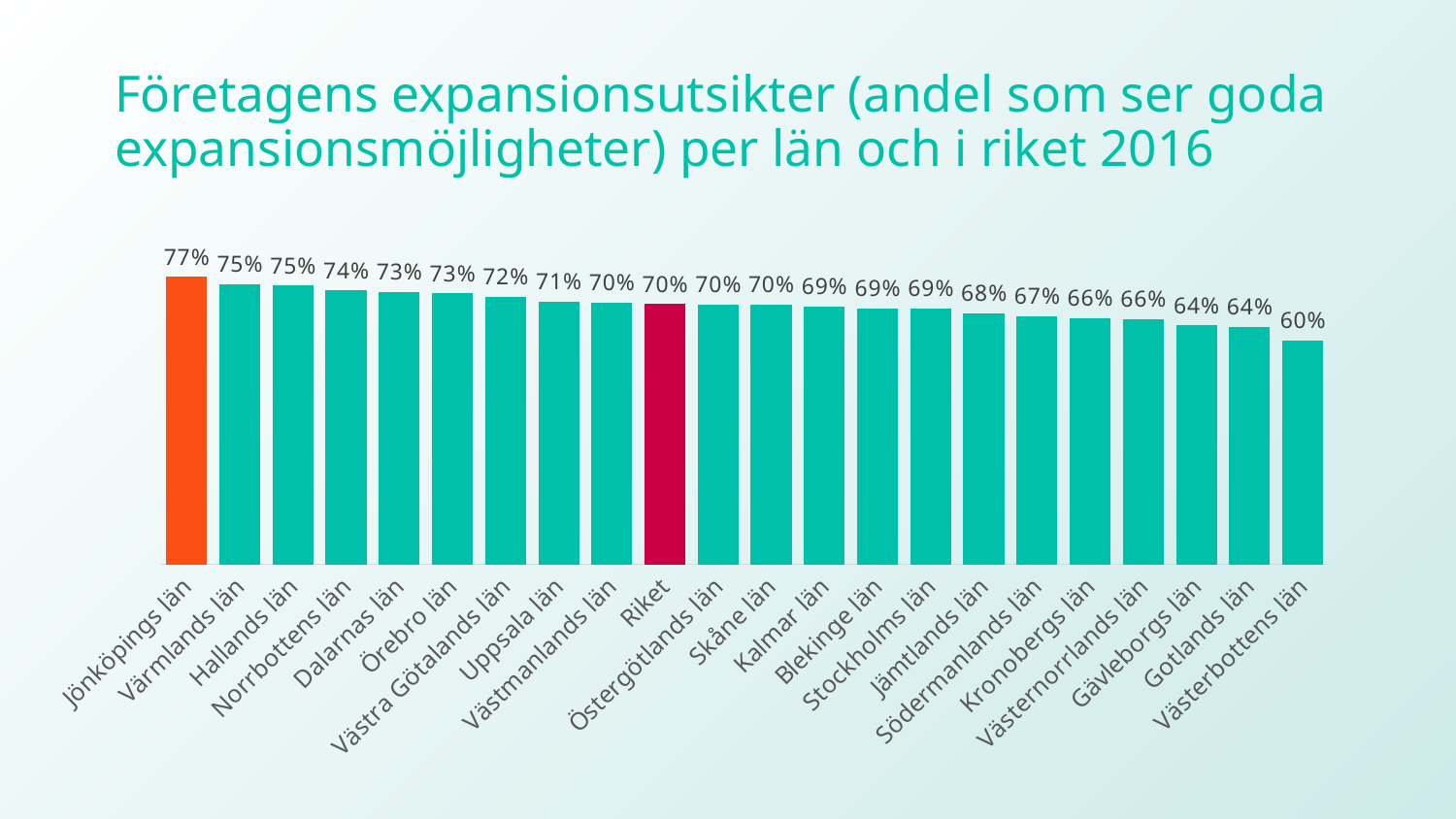
What is the value for Riket? 70% What is the difference between the values for Jönköpings län and Västerbottens län? 17% What is the difference between the values for Norrbottens län and Riket? 4% Which category has the highest value? Jönköpings län What is the value for Stockholms län? 69% Which bar is coloured orange? Jönköpings län What is the value for Jönköpings län? 77% Which has a larger value, Uppsala län or Jämtlands län? Uppsala län Which category has the lowest value? Västerbottens län What type of chart is shown on the slide? Bar chart What is the value for Gotlands län? 64% How many bars are shown in the chart? 22